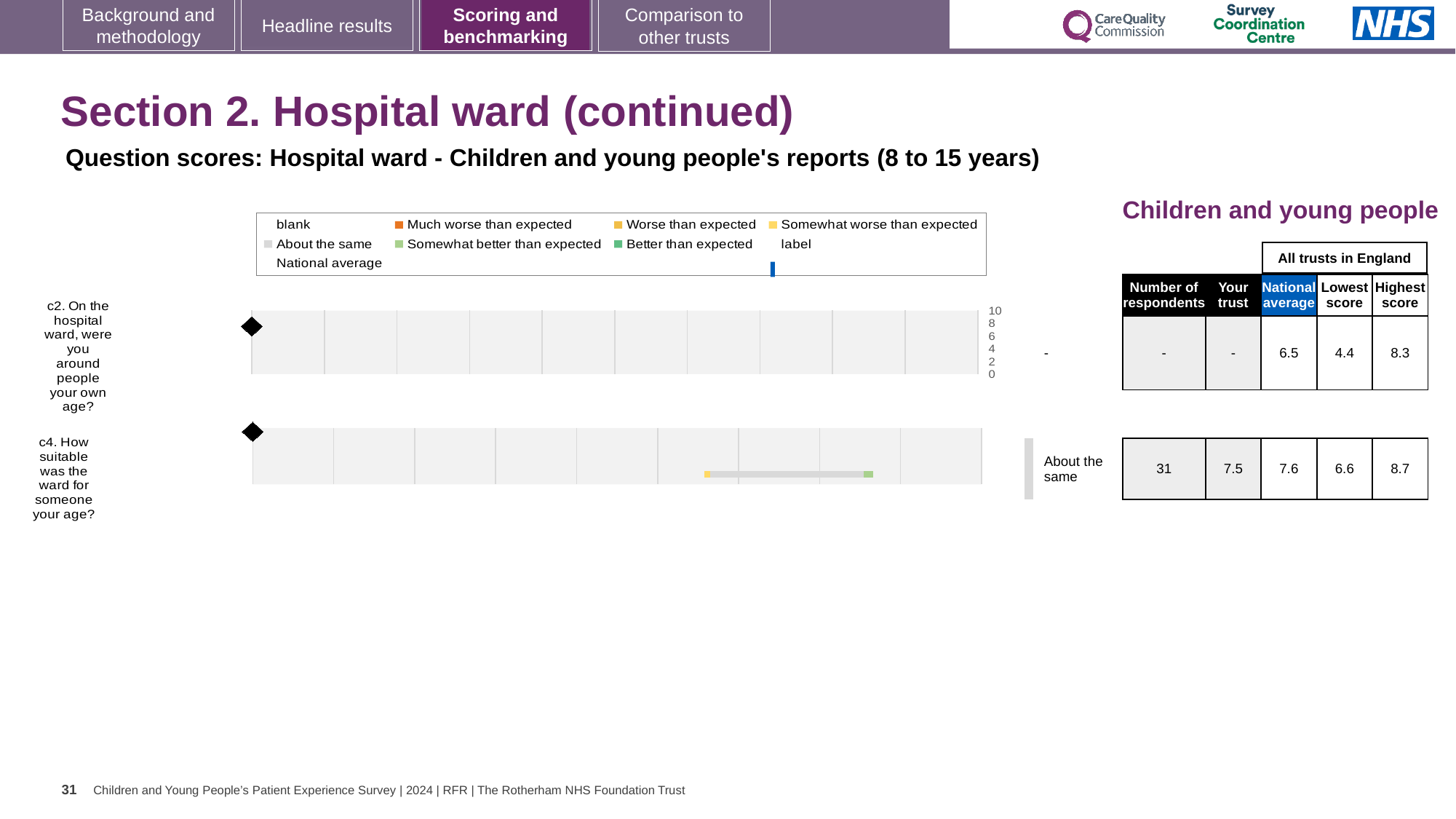
What is the national average score for question c4? 7.6 What is the highest score across all trusts in England for question c4? 8.7 What is the national average score for question c2 (On the hospital ward, were you around people your own age?)? 6.5 How many respondents are shown for question c4? 31 What benchmark category is shown for question c4? About the same What is the difference between the highest and lowest scores for question c2? 3.9 For question c4, which is larger: the 'Your trust' score or the national average? National average What is the lowest score across all trusts in England for question c4? 6.6 What is the difference between the highest and lowest scores for question c4? 2.1 What is the 'Your trust' score for question c4 (How suitable was the ward for someone your age?)? 7.5 What is the highest score across all trusts in England for question c2? 8.3 How many questions are plotted on the chart? 2